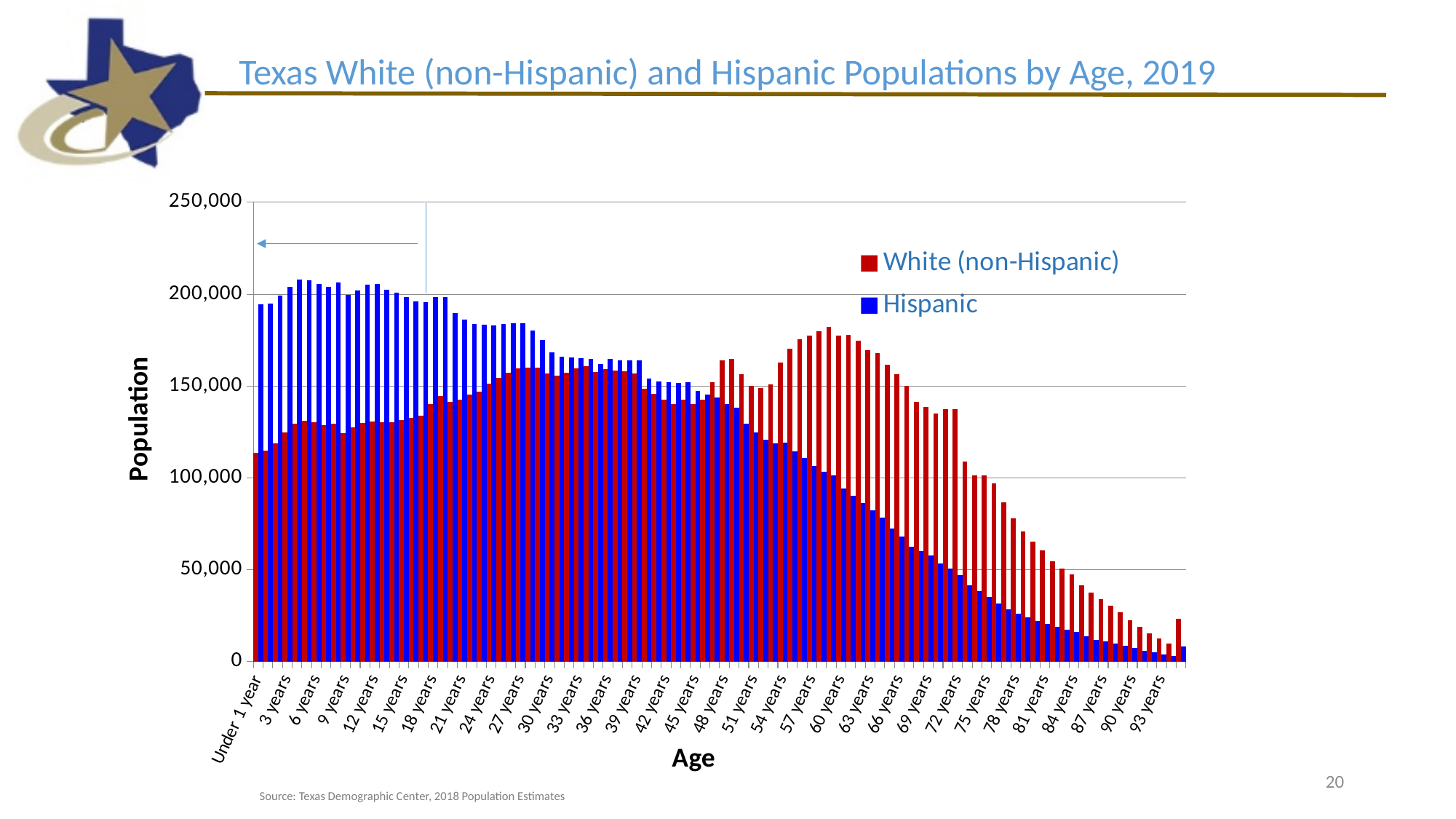
What kind of chart is shown on the slide? Bar chart How many series does the legend list? 2 Is the Hispanic value for 90 years greater or less than 50,000? less For 60 years, which series has the larger value, White (non-Hispanic) or Hispanic? White (non-Hispanic) Is the Hispanic value for Under 1 year greater or less than 150,000? greater Is the White (non-Hispanic) value for Under 1 year greater or less than 150,000? less For Under 1 year, which series has the larger value, White (non-Hispanic) or Hispanic? Hispanic What are the two series named in the legend? White (non-Hispanic) and Hispanic Do the Hispanic values generally rise or fall as age increases along the x axis? fall What is the label on the vertical axis? Population